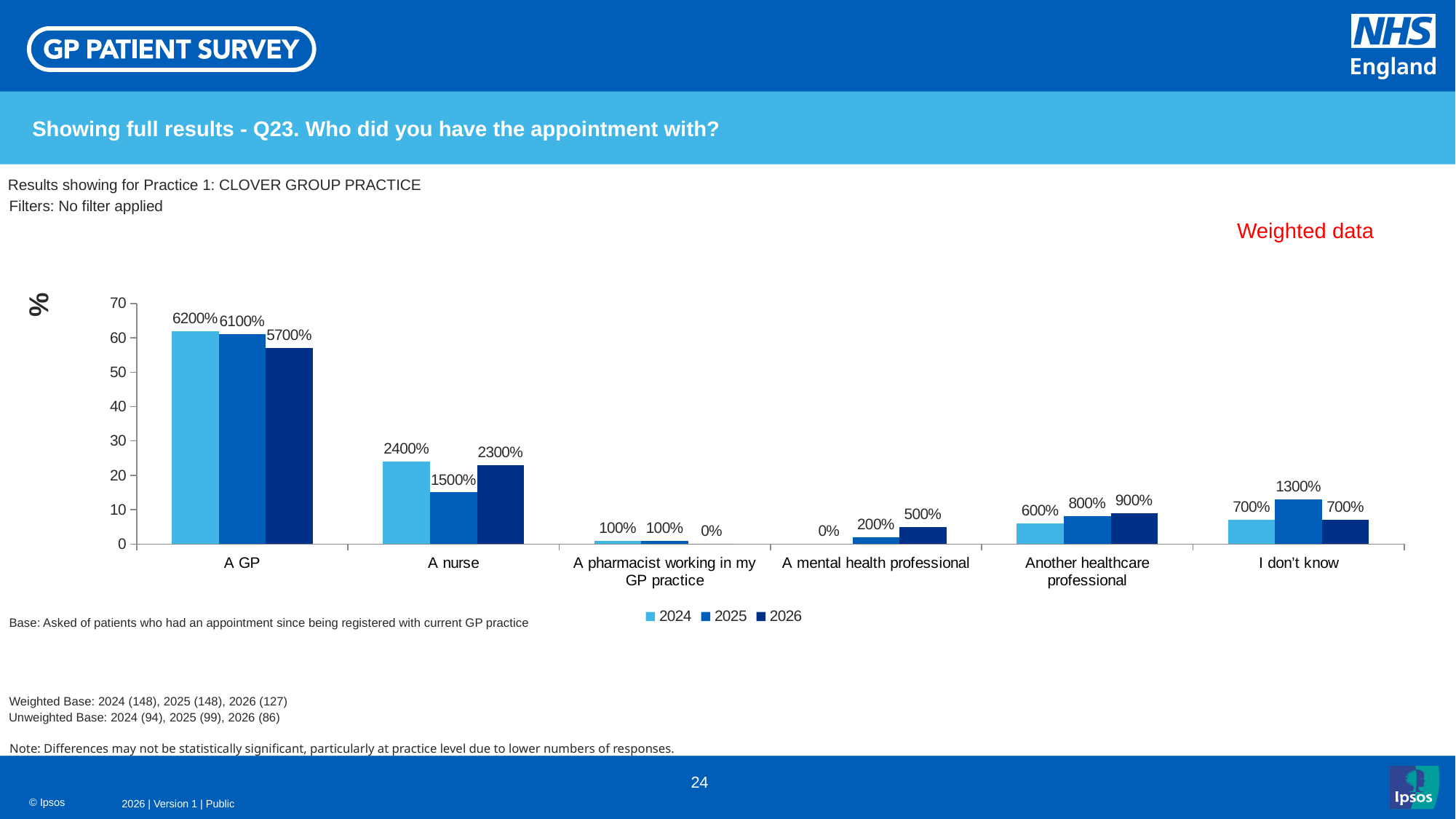
What is the 2026 value for A mental health professional? 500% How many series does the legend list? 3 What is the 2025 value for I don't know? 1300% What is the 2025 value for A nurse? 1500% Which category has the highest 2026 value? A GP Do the values for A GP rise or fall from 2024 to 2026? Fall What is the difference between the 2024 and 2026 values for A GP? 500% How many categories are shown on the x axis? 6 What is the 2024 value for A GP? 6200% Which category has the lowest 2024 value? A mental health professional What kind of chart is shown on the slide? Bar chart Which is larger for A nurse: the 2024 value or the 2026 value? 2024